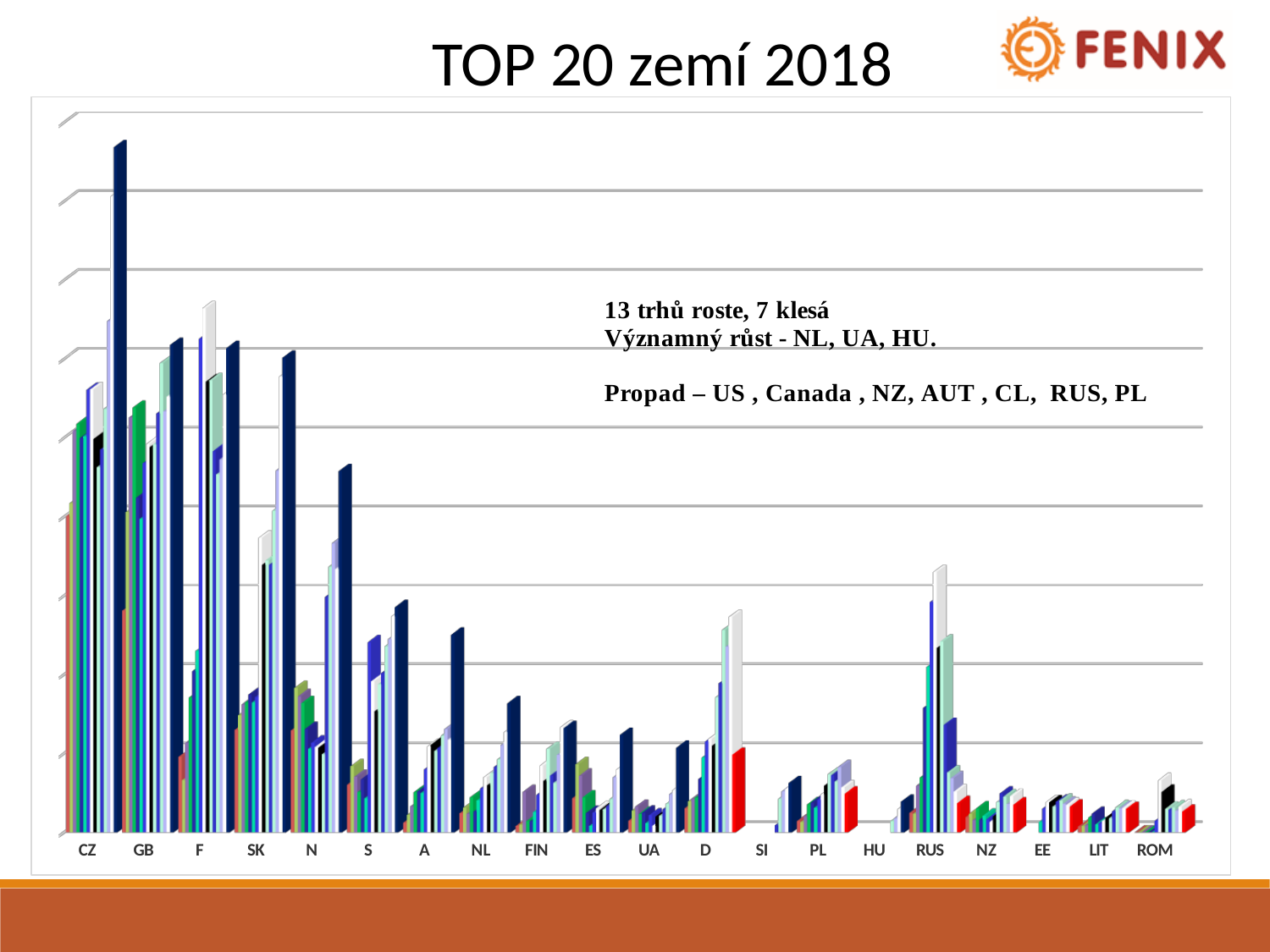
How many countries are shown on the x axis of the chart? 20 Which country has taller bars, D or UA? D What is the first country label on the x axis? CZ Which country's tallest bar is higher, CZ or GB? CZ What kind of chart is shown on the slide? bar chart Do the bars generally get shorter or taller moving from CZ on the left to ROM on the right? shorter What is the title of the slide containing the chart? TOP 20 zemí 2018 Which country has the tallest bar in the chart? CZ Which country has taller bars, F or A? F